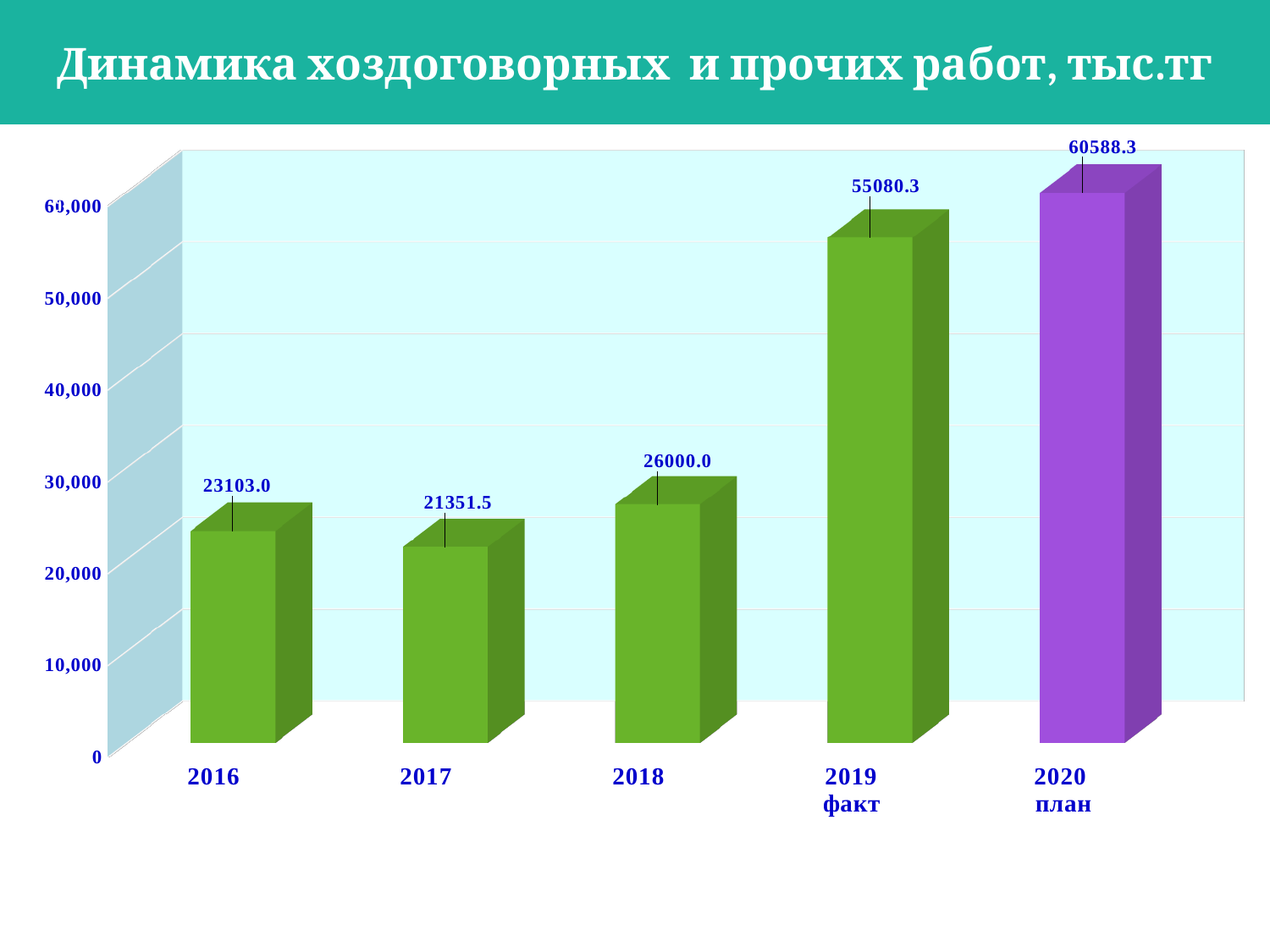
What is the value for 2019 факт? 55080.3 What is the value for 2020 план? 60588.3 What is the difference between the values for 2018 and 2017? 4648.5 Which category has the highest value? 2020 план What kind of chart is shown on the slide? Bar chart Which is larger, the value for 2016 or the value for 2018? 2018 What is the title of the chart? Динамика хоздоговорных и прочих работ, тыс.тг How many categories are shown on the x axis? 5 What is the value for 2016? 23103.0 What is the value for 2017? 21351.5 What is the difference between the values for 2020 план and 2019 факт? 5508.0 Which category has the lowest value? 2017